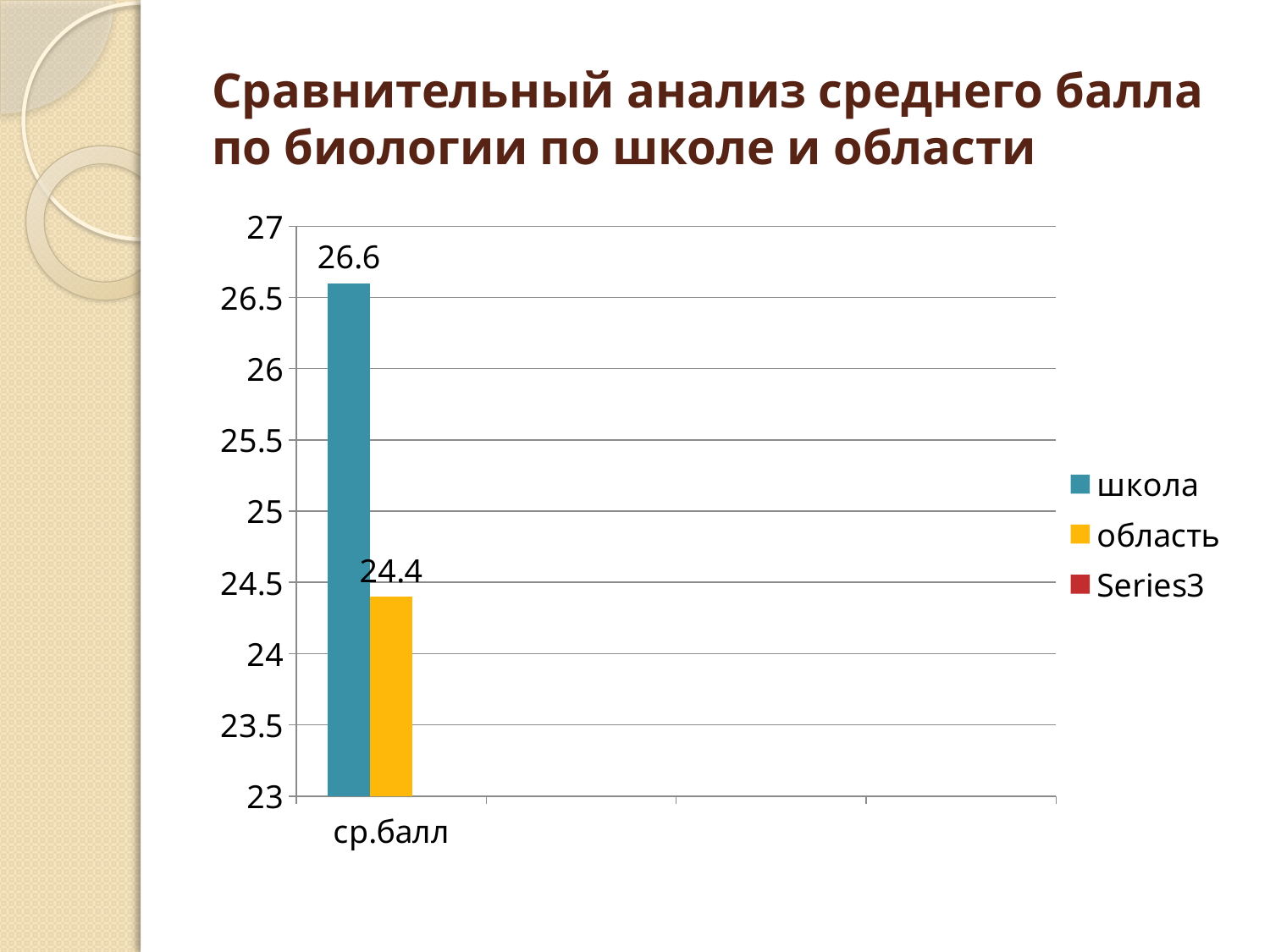
What colour is the bar for школа? teal (blue) What is the value for область in the ср.балл category? 24.4 What is the label of the category on the x axis? ср.балл Is the value for школа greater or less than 26? greater How many series does the legend list? 3 What is the maximum value shown on the y axis? 27 What kind of chart is shown on the slide? bar chart What is the value for школа in the ср.балл category? 26.6 What is the difference between the школа value and the область value? 2.2 Which series has the lowest plotted value? область Is the value for область greater or less than 25? less Which series has the higher value: школа or область? школа